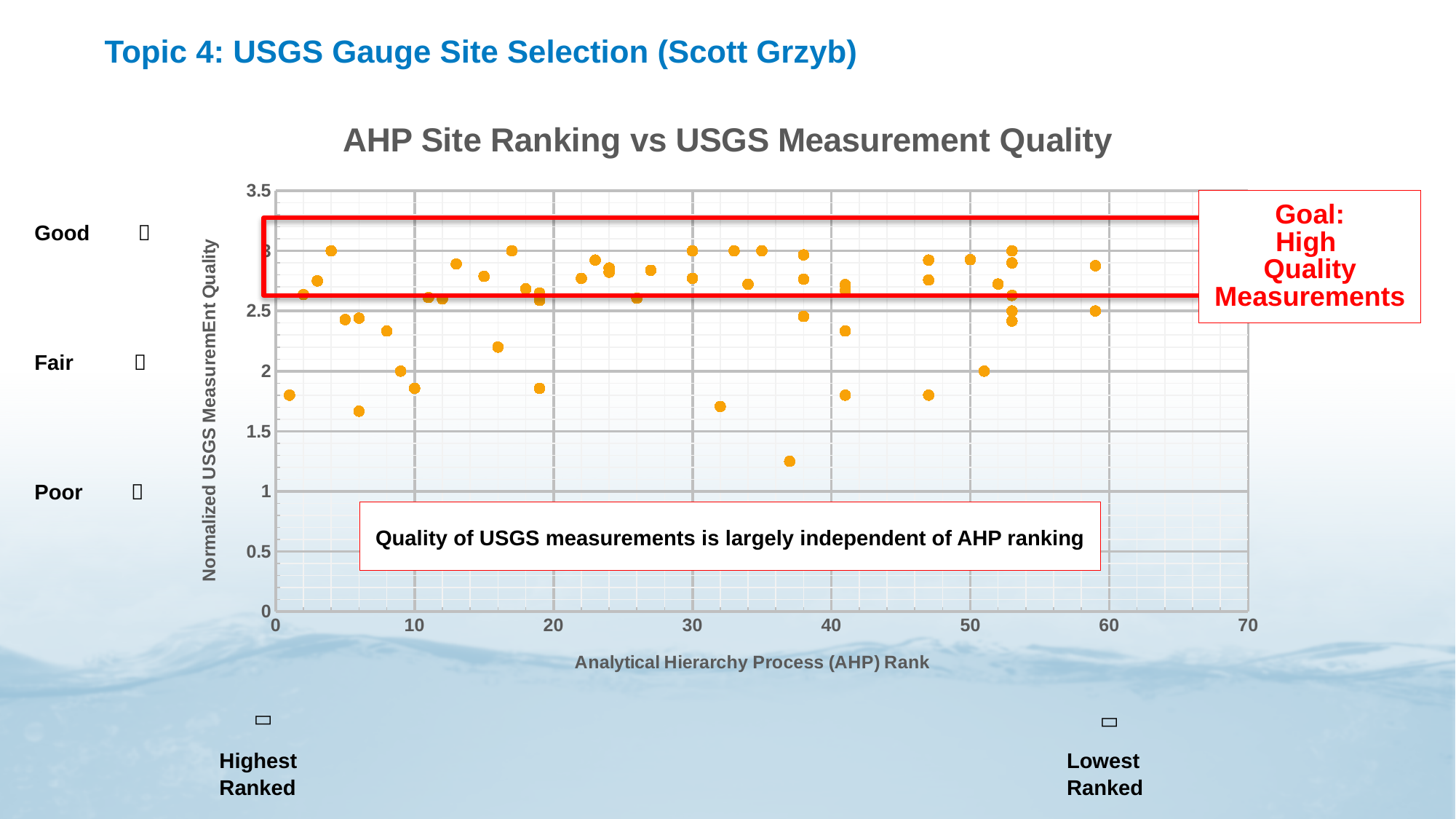
Is the measurement quality value for the point at AHP rank 16 greater or less than 2? greater Is the lowest plotted measurement quality value on the chart greater or less than 1.5? less Is the measurement quality value for the point at AHP rank 8 greater or less than 2.5? less What is the label of the x axis of the chart? Analytical Hierarchy Process (AHP) Rank Is the measurement quality value for the point at AHP rank 51 greater or less than 2.5? less What kind of chart is shown on the slide? scatter chart What is the title of the chart? AHP Site Ranking vs USGS Measurement Quality